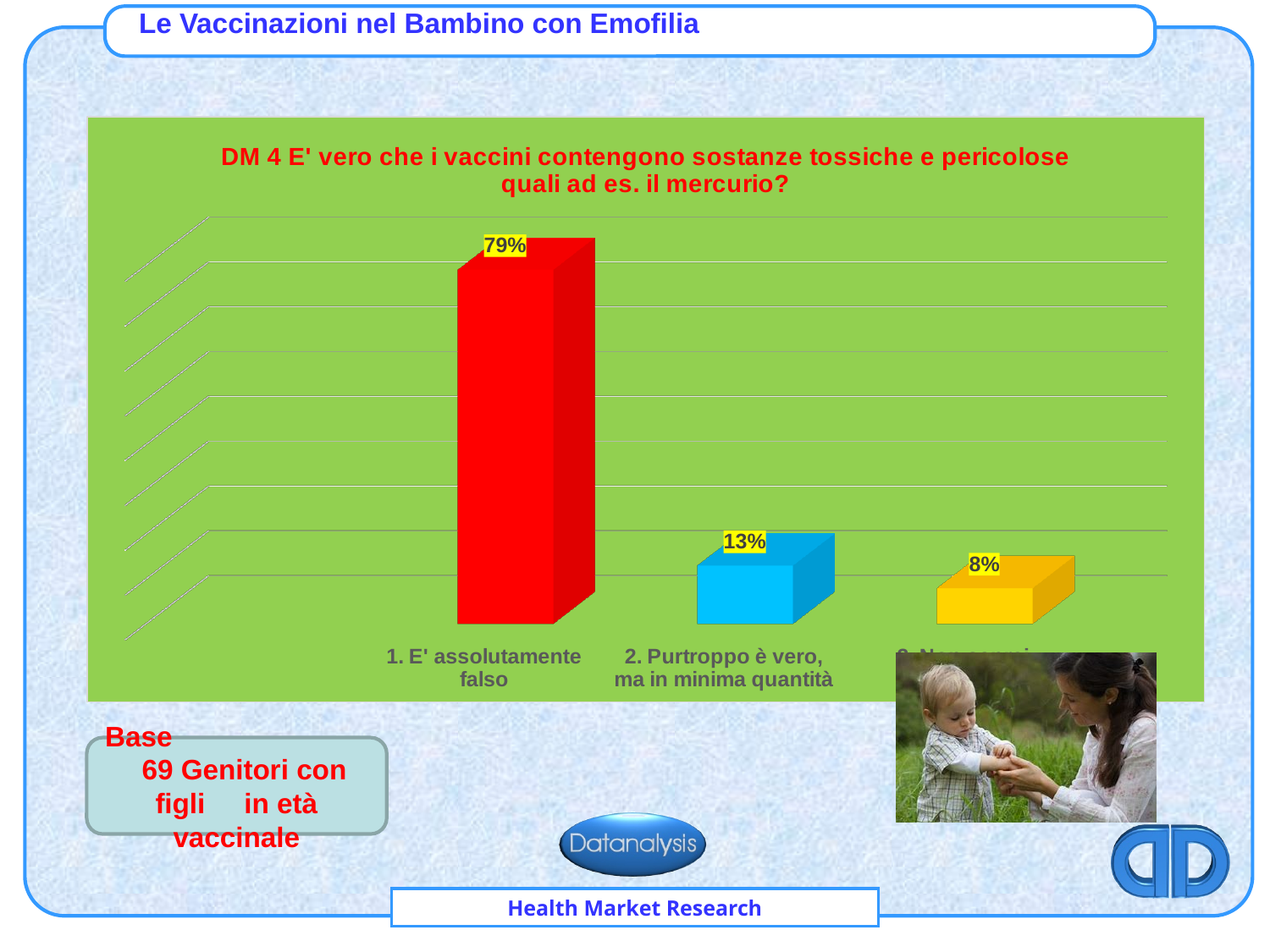
What is the difference between the values for "1. E' assolutamente falso" and "2. Purtroppo è vero, ma in minima quantità"? 66 percentage points What is the title of the chart? DM 4 E' vero che i vaccini contengono sostanze tossiche e pericolose quali ad es. il mercurio? Which is larger: the value for "2. Purtroppo è vero, ma in minima quantità" or the value of the rightmost bar? 2. Purtroppo è vero, ma in minima quantità What is the value shown on the rightmost (yellow) bar? 8% Which category has the highest value? 1. E' assolutamente falso What kind of chart is shown on the slide? Bar chart What is the value for "1. E' assolutamente falso"? 79% What is the value for "2. Purtroppo è vero, ma in minima quantità"? 13% Do the values rise or fall from left to right across the bars? Fall What colour is the bar for "1. E' assolutamente falso"? Red What is the lowest value shown in the chart? 8% How many bars are plotted in the chart? 3